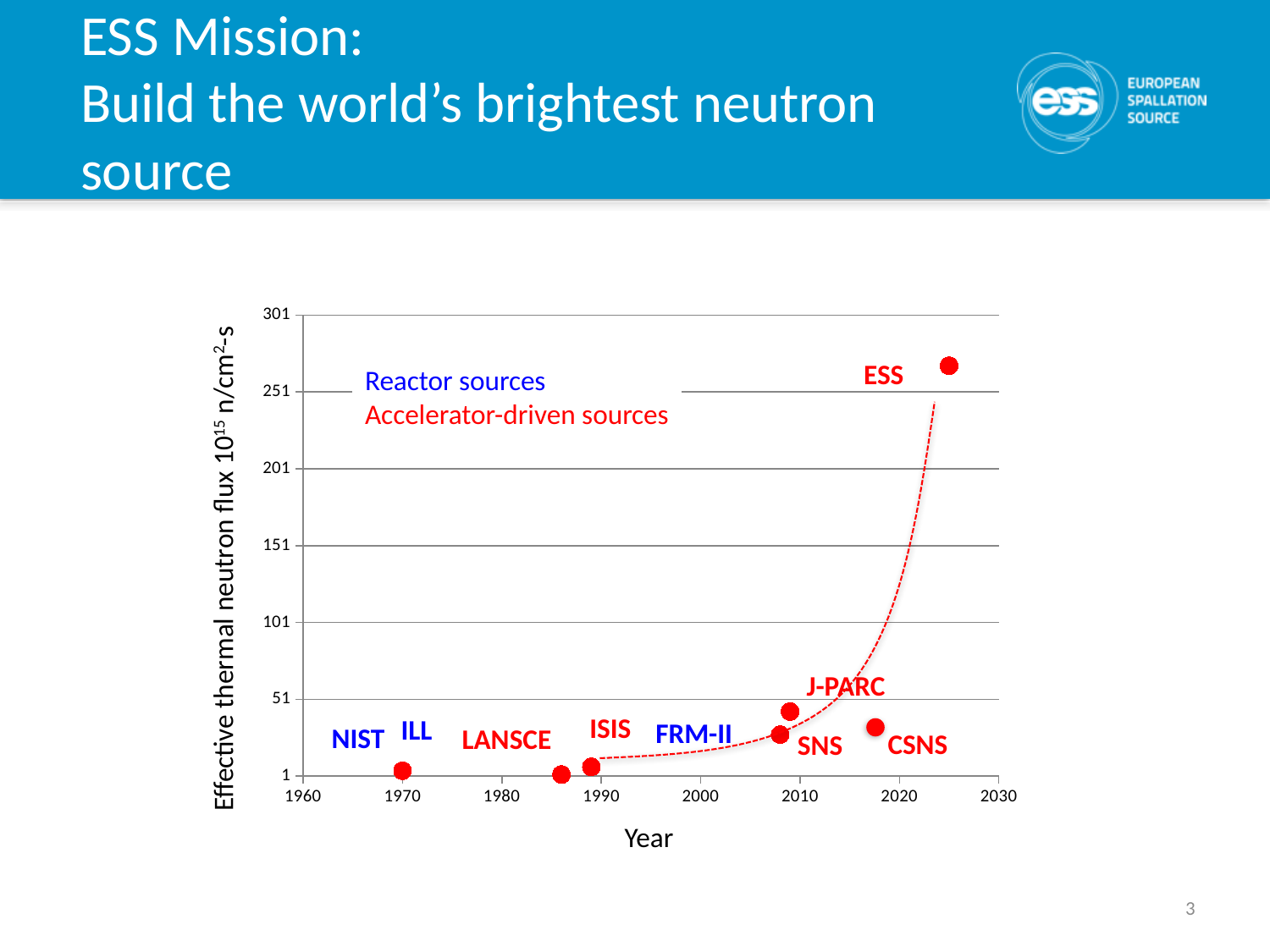
How many facility labels are shown on the chart? 9 Which has a higher effective thermal neutron flux, J-PARC or LANSCE? J-PARC Which colour is used for reactor sources in the chart's legend? blue What kind of chart is shown on the slide? scatter chart Is the value for J-PARC greater or less than 51? less What is the label of the x axis? Year Which facility has the highest effective thermal neutron flux on the chart? ESS Which has a higher effective thermal neutron flux, ESS or J-PARC? ESS Does the effective thermal neutron flux generally rise or fall as the year increases? rise Is the value for ESS greater or less than 201? greater Is the value for CSNS greater or less than 101? less